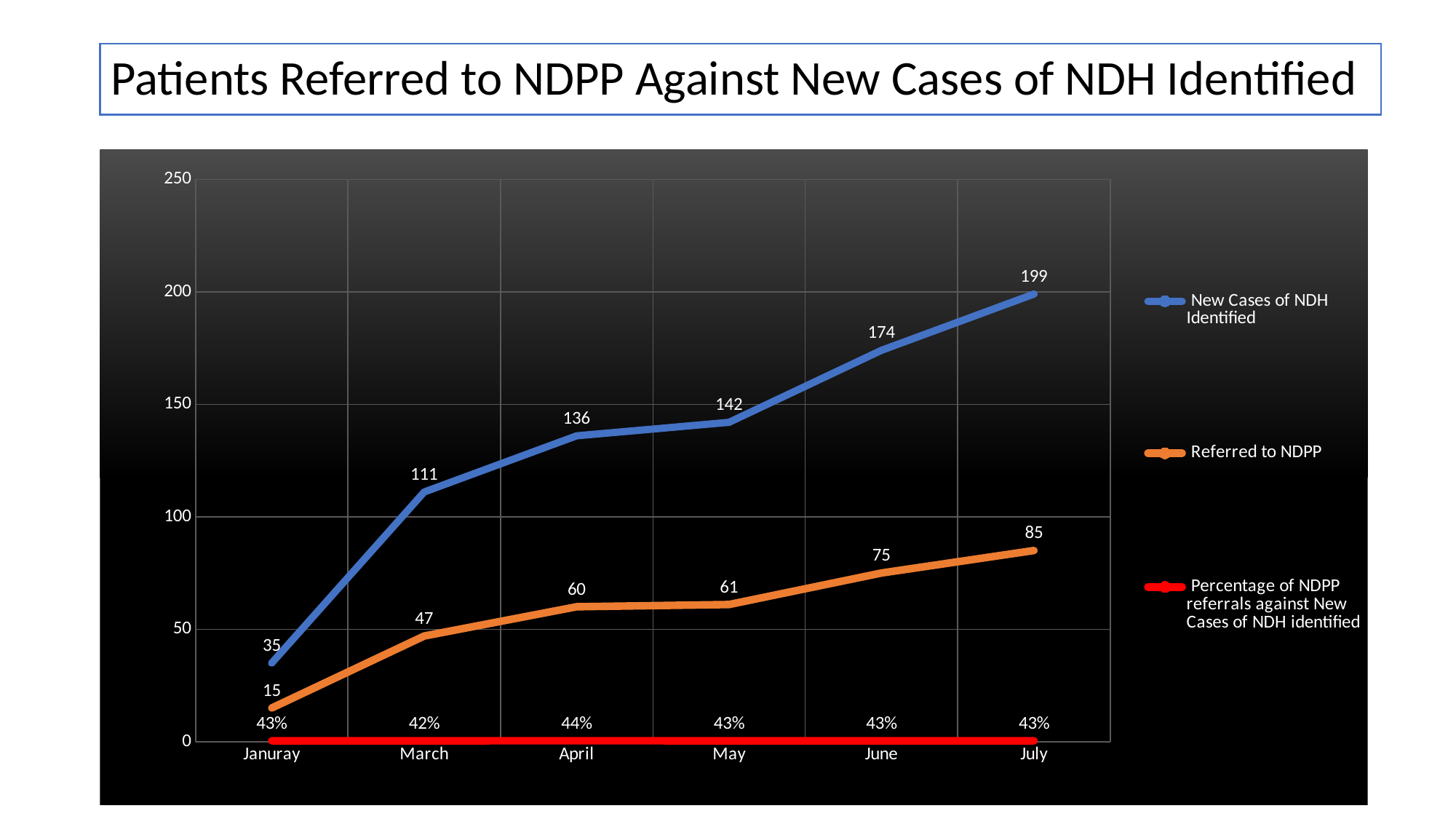
Which is larger: Referred to NDPP in April or in May? May What is the value for New Cases of NDH Identified in March? 111 What is the difference between New Cases of NDH Identified and Referred to NDPP in July? 114 How many series does the legend list? 3 What kind of chart is shown on the slide? Line chart Does the number of New Cases of NDH Identified rise or fall from January to July? Rise What is the Percentage of NDPP referrals against New Cases of NDH identified in April? 44% In which month is the number of New Cases of NDH Identified highest? July What colour is the line for Referred to NDPP? Orange What is the value for Referred to NDPP in June? 75 How many months are shown on the x axis? 6 In which month is the number of patients Referred to NDPP lowest? Januray